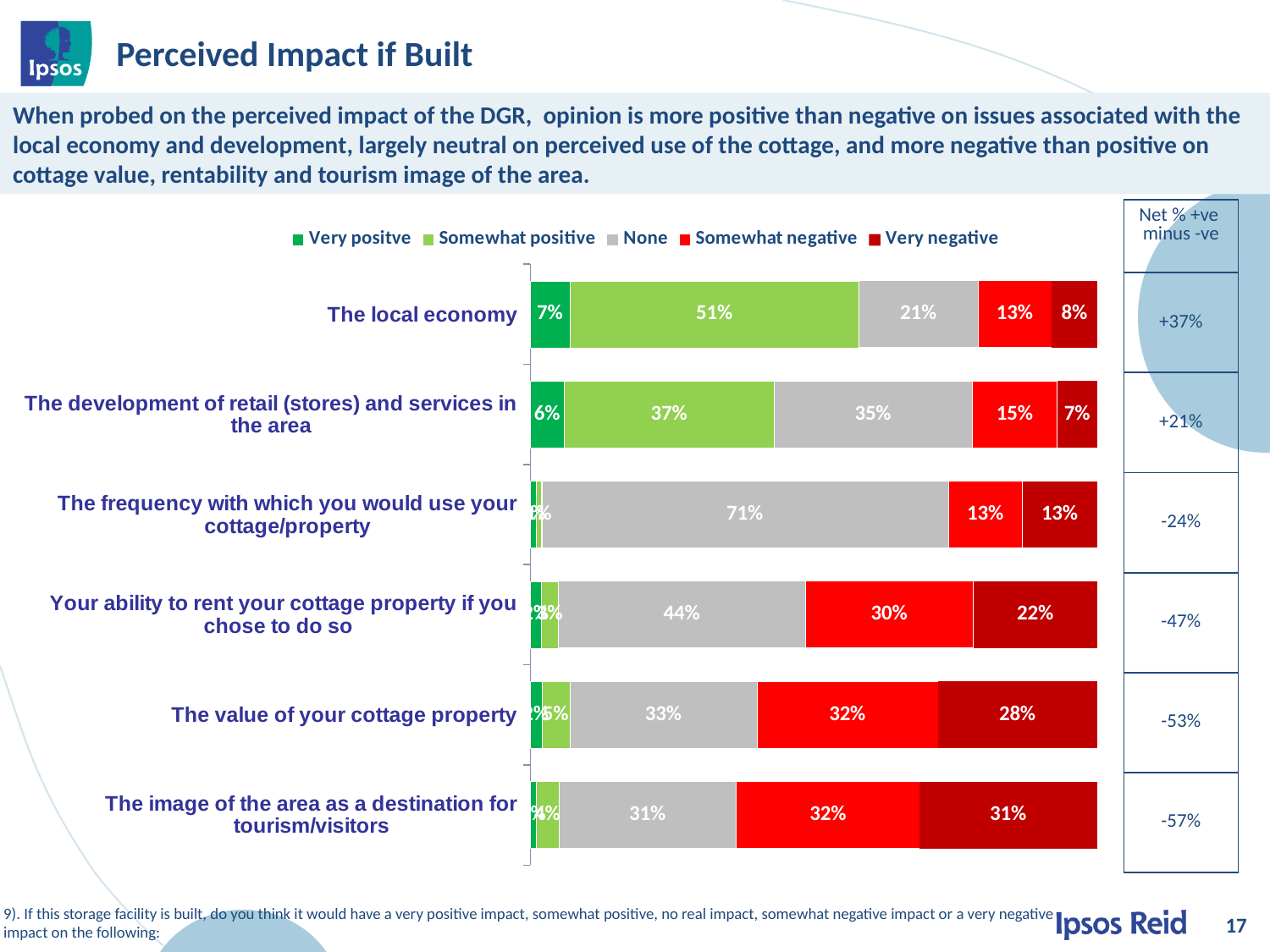
What is the 'Somewhat positive' value for 'The local economy'? 51% What is the 'None' value for 'The frequency with which you would use your cottage/property'? 71% Which category has the highest 'None' value? The frequency with which you would use your cottage/property Which legend entry is shown in grey? None How many categories are plotted on the chart? 6 Which is larger: the 'Very negative' value for 'The value of your cottage property' or for 'Your ability to rent your cottage property if you chose to do so'? The value of your cottage property What is the difference between the 'Somewhat positive' values for 'The local economy' and 'The development of retail (stores) and services in the area'? 14% What is the 'Very negative' value for 'The image of the area as a destination for tourism/visitors'? 31% Which category has the lowest 'Very negative' value? The development of retail (stores) and services in the area What is the 'Somewhat negative' value for 'Your ability to rent your cottage property if you chose to do so'? 30% What kind of chart is shown on the slide? Stacked bar chart How many series does the legend list? 5